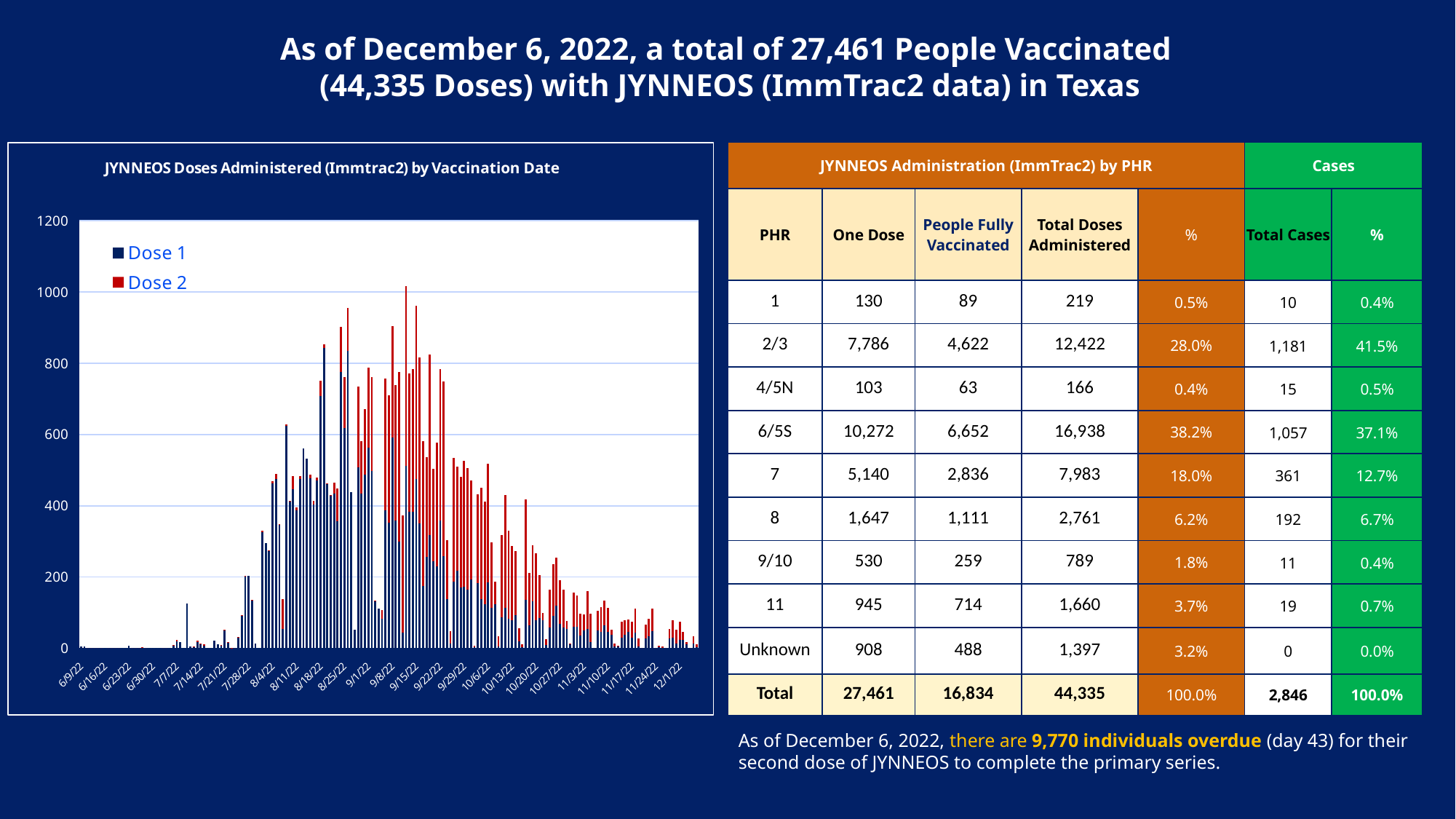
What is the title of the chart? JYNNEOS Doses Administered (Immtrac2) by Vaccination Date Is the tallest bar in the chart greater or less than 800? greater Are the bars around 6/16/22 greater or less than 200? less Do the bar heights generally rise or fall between 10/6/22 and 12/1/22? fall What is the highest value shown on the chart's vertical axis? 1200 What is the last date label on the chart's x axis? 12/1/22 What kind of chart is shown on the left of the slide? bar chart What is the first date label on the chart's x axis? 6/9/22 Do the bar heights generally rise or fall between 7/21/22 and 8/25/22? rise Are the bars around 12/1/22 greater or less than 400? less What are the two series named in the chart legend? Dose 1 and Dose 2 How many series does the legend of the chart list? 2